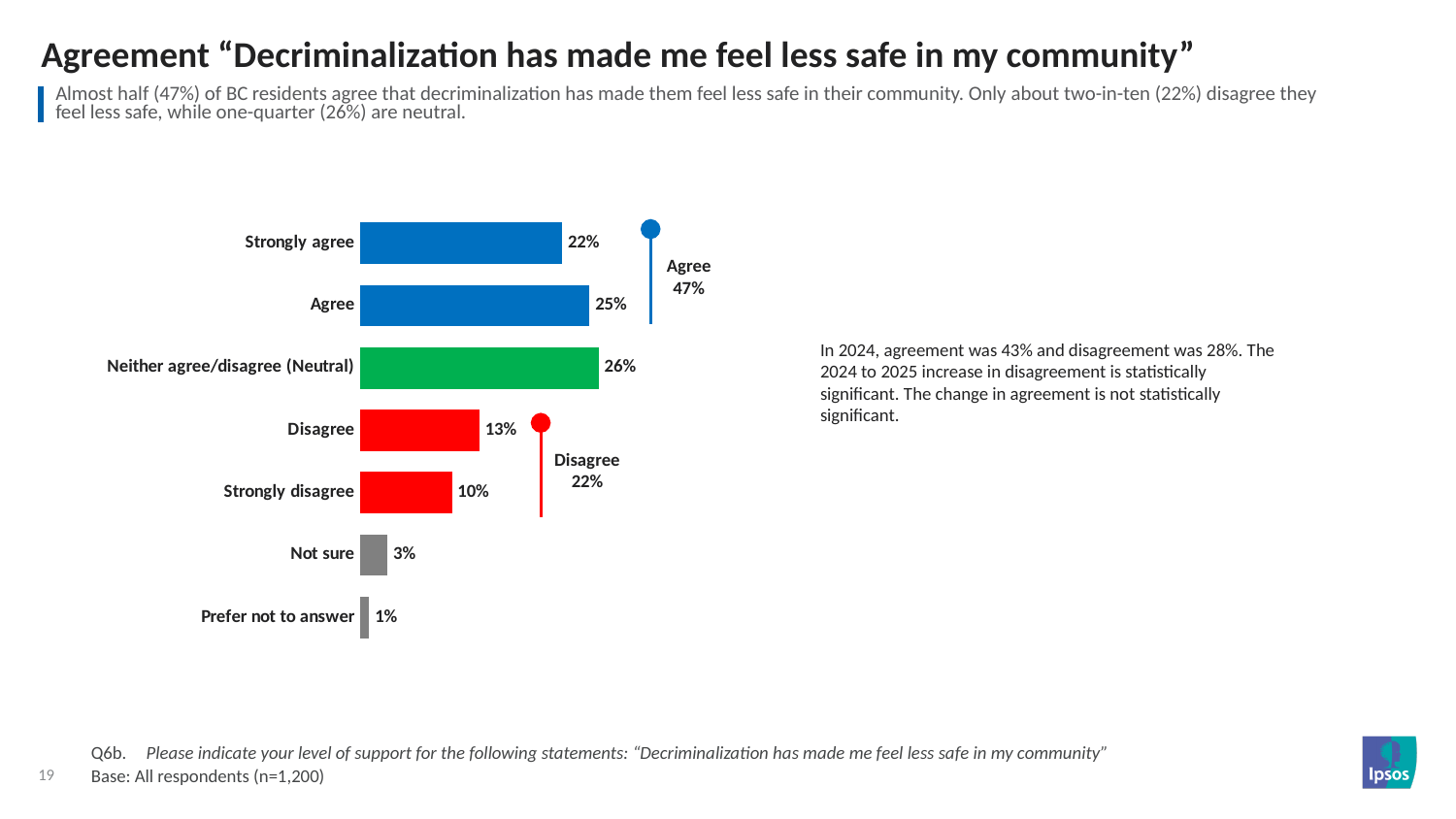
What colour are the 'Disagree' and 'Strongly disagree' bars? Red Which response category has the lowest percentage? Prefer not to answer Which is larger, the percentage for 'Strongly agree' or for 'Strongly disagree'? Strongly agree What percentage of respondents chose 'Neither agree/disagree (Neutral)'? 26% How many response categories are shown in the chart? 7 What is the combined 'Agree' percentage shown on the chart? 47% What percentage of respondents chose 'Strongly disagree'? 10% Which response category has the highest percentage? Neither agree/disagree (Neutral) What is the difference in percentage points between 'Agree' and 'Disagree'? 12 What type of chart is shown on the slide? Bar chart What percentage of respondents chose 'Strongly agree'? 22% What percentage of respondents chose 'Prefer not to answer'? 1%